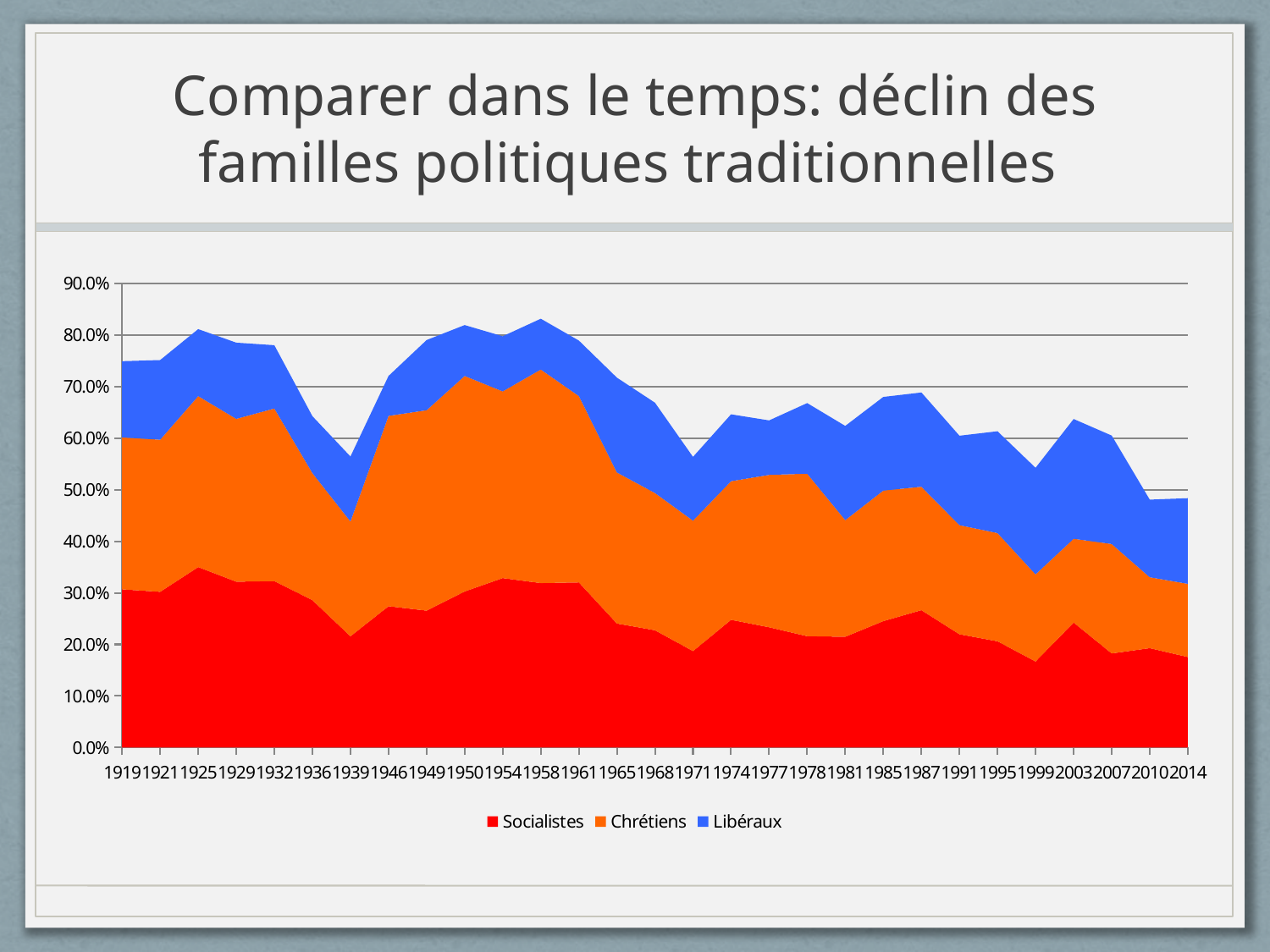
Is the combined total of the three families in 1939 greater or less than 50.0%? greater Which series is at the bottom of the stack? Socialistes What kind of chart is shown on the slide? area chart How many series does the legend list? 3 How many years are shown along the x axis? 29 Is the value for Socialistes in 1999 greater or less than 20.0%? less Which series is shown in blue? Libéraux Does the combined total of the three families rise or fall from 1919 to 2014? fall Which is larger, the combined total of the three families in 1958 or in 2014? 1958 Is the combined total of the three families in 1958 greater or less than 80.0%? greater Which is larger, the value for Socialistes in 1925 or in 1999? 1925